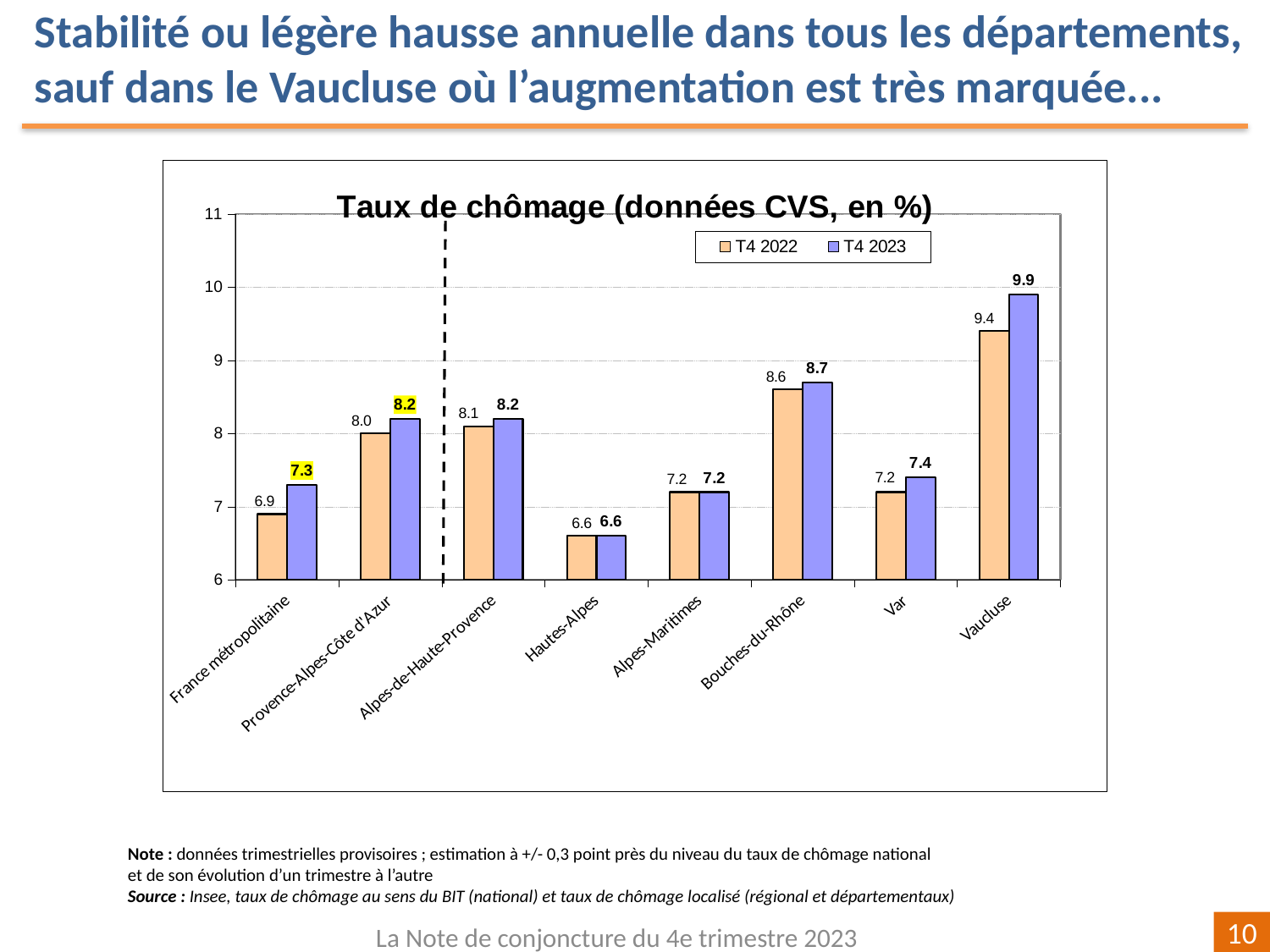
How many categories are shown on the x axis? 8 What is the T4 2023 unemployment rate for Vaucluse? 9.9 Which category has the highest T4 2023 value? Vaucluse What is the difference between the T4 2023 and T4 2022 values for France métropolitaine? 0.4 How many series does the legend list? 2 Is the T4 2023 value for Bouches-du-Rhône greater or less than 8? greater Which category has the lowest T4 2022 value? Hautes-Alpes What is the difference between the T4 2023 and T4 2022 values for Vaucluse? 0.5 What type of chart is shown? bar chart What is the T4 2022 unemployment rate for France métropolitaine? 6.9 Which is larger: the T4 2023 value for Var or the T4 2023 value for Alpes-Maritimes? Var What is the T4 2022 value for Bouches-du-Rhône? 8.6